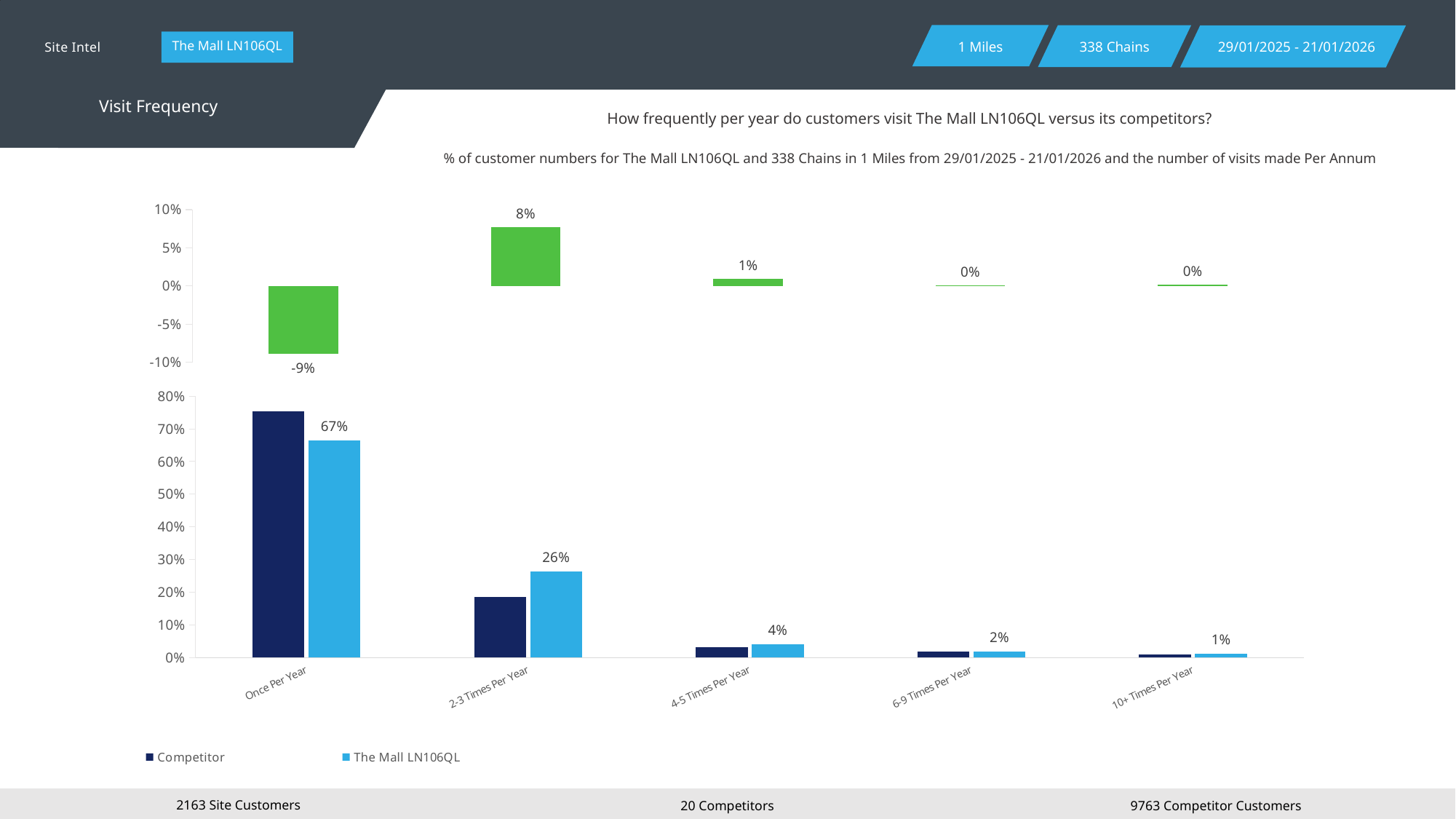
In the lower bar chart, what is the value for The Mall LN106QL in the 4-5 Times Per Year category? 4% In the lower bar chart, is the Competitor value for 2-3 Times Per Year greater or less than 20%? less In the lower bar chart, what is the value for The Mall LN106QL in the 2-3 Times Per Year category? 26% In the upper green chart, what is the value shown for the first category (aligned with Once Per Year)? -9% In the lower bar chart, is the Competitor value for Once Per Year greater or less than 70%? greater In the lower bar chart, which category has the highest value for The Mall LN106QL? Once Per Year How many categories are shown on the x axis of the lower bar chart? 5 In the lower bar chart, what is the value for The Mall LN106QL in the Once Per Year category? 67% In the lower bar chart, for the Once Per Year category, which series has the larger value: Competitor or The Mall LN106QL? Competitor In the lower bar chart, what is the difference between The Mall LN106QL values for Once Per Year and 2-3 Times Per Year? 41 percentage points In the upper green chart, what is the value shown for the second category (aligned with 2-3 Times Per Year)? 8% How many series does the legend of the lower bar chart list? 2